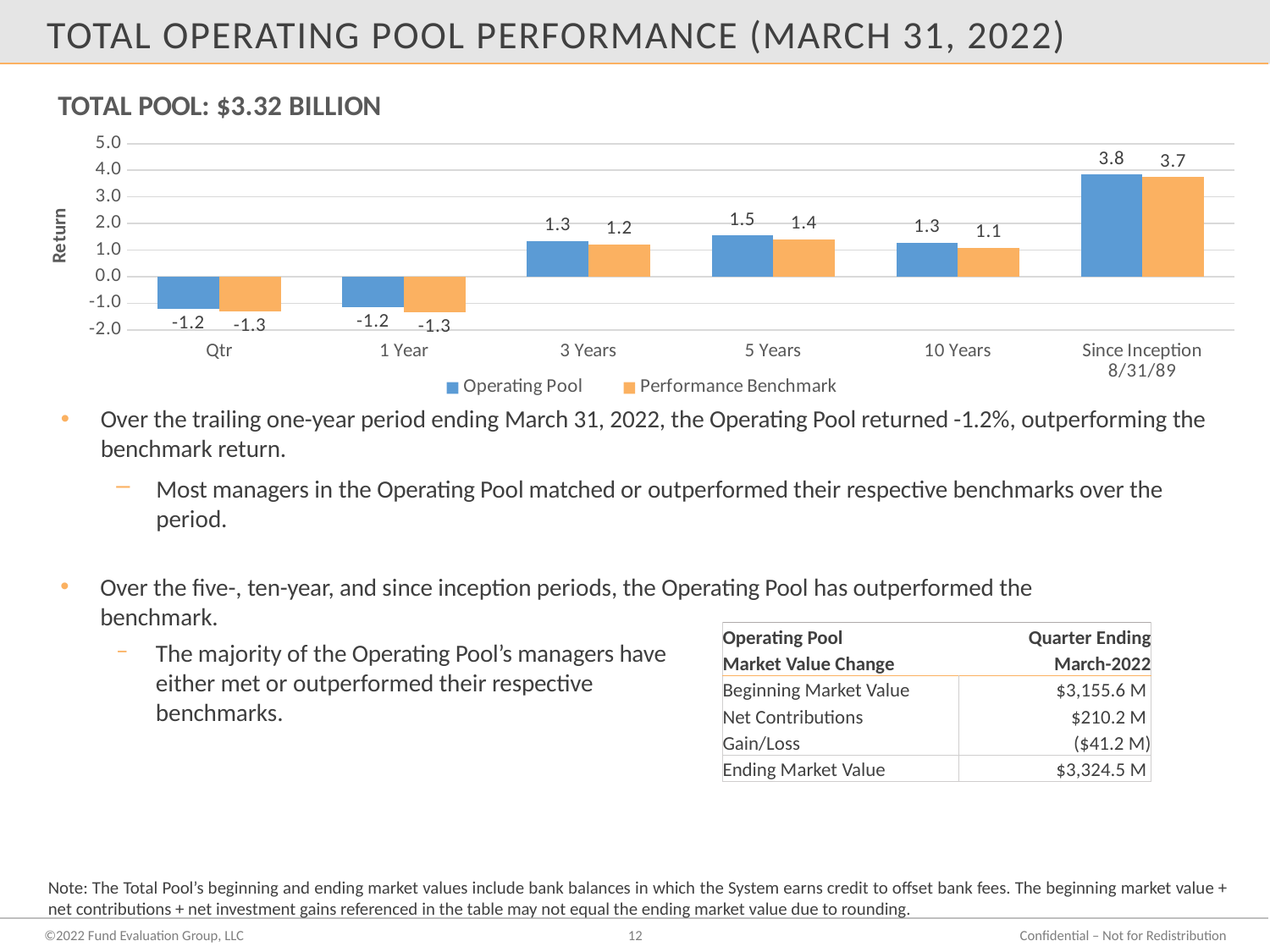
What is the Operating Pool return for the 3 Years period? 1.3 What is the Performance Benchmark return for the 10 Years period? 1.1 For the 5 Years period, which is larger: the Operating Pool return or the Performance Benchmark return? Operating Pool What is the Operating Pool return for the Since Inception 8/31/89 period? 3.8 How many series does the chart legend list? 2 What kind of chart is shown on the slide? Bar chart Which period has the highest Operating Pool return? Since Inception 8/31/89 What is the Performance Benchmark return for the Qtr period? -1.3 What is the difference between the Operating Pool and Performance Benchmark returns for the 10 Years period? 0.2 How many periods are shown on the x axis of the chart? 6 Which period has the lowest Performance Benchmark return? Qtr and 1 Year (both -1.3) What is the title of the chart? TOTAL POOL: $3.32 BILLION